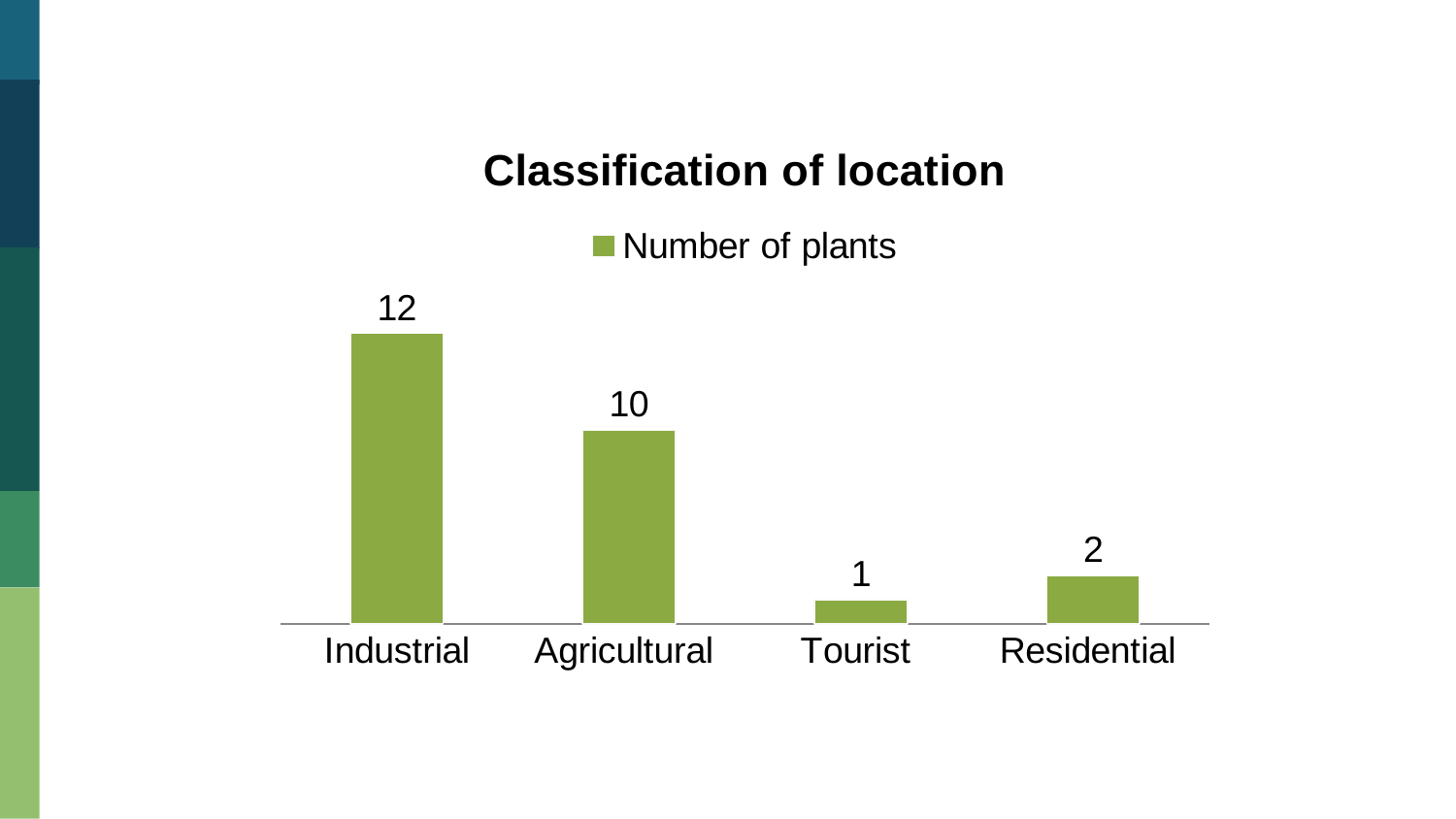
Which location classification has the lowest number of plants? Tourist Which location classification has the highest number of plants? Industrial Which has more plants, Residential or Tourist? Residential How many location categories are shown in the chart? 4 What is the number of plants for Residential? 2 What is the difference in number of plants between Industrial and Agricultural? 2 What type of chart is shown on the slide? Bar chart What is the number of plants for Agricultural? 10 What is the title of the chart? Classification of location What is the number of plants for Industrial? 12 What is the number of plants for Tourist? 1 What is the difference in number of plants between Agricultural and Residential? 8